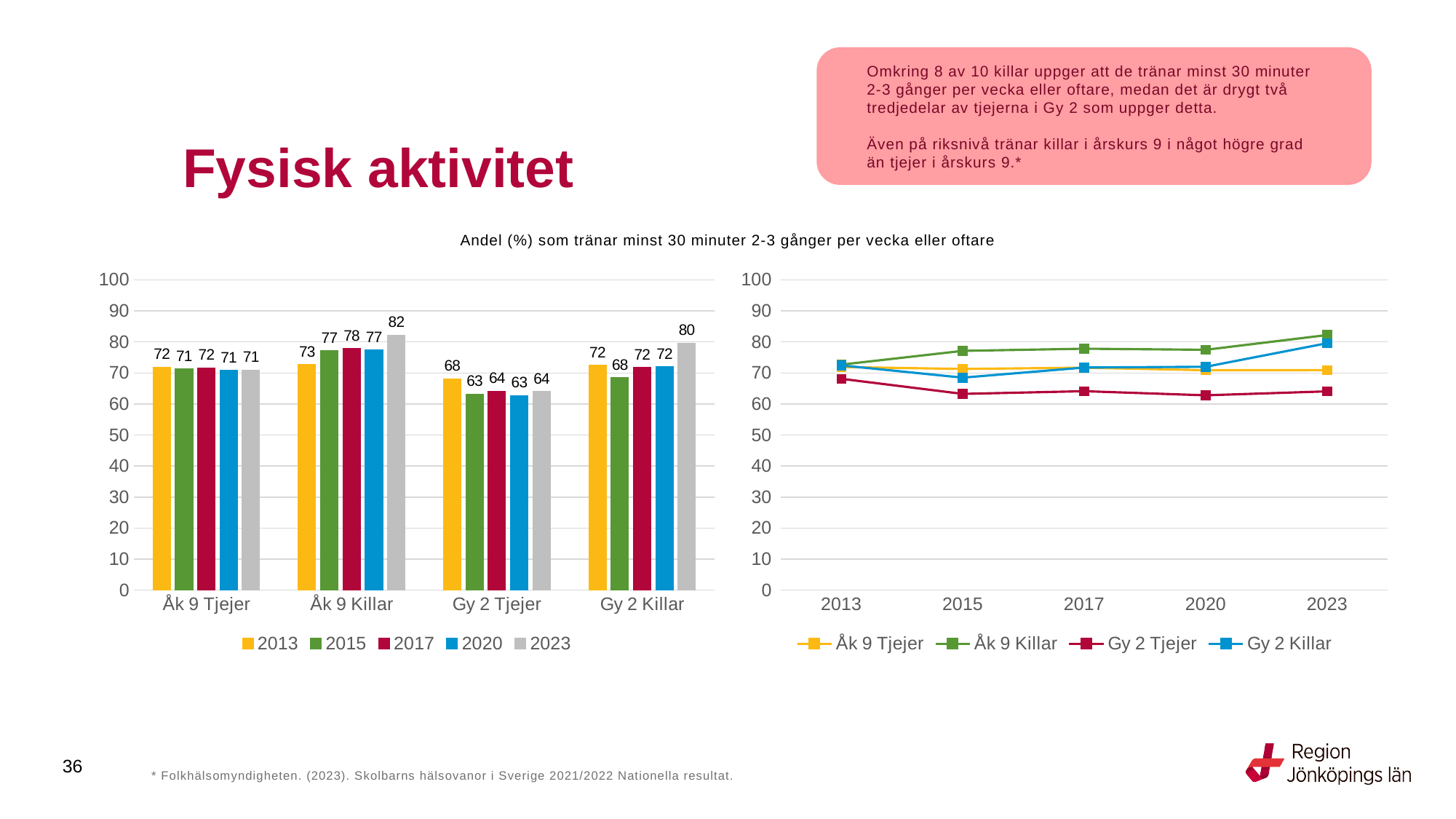
In the bar chart on the left, what is the difference between the 2023 values for Åk 9 Killar and Gy 2 Tjejer? 18 What kind of chart is the chart on the right? Line chart In the bar chart on the left, what is the value for Gy 2 Killar in 2023? 80 In the bar chart on the left, what is the value for Gy 2 Tjejer in 2015? 63 In the bar chart on the left, what is the value for Åk 9 Killar in 2023? 82 How many series does the legend of the bar chart on the left list? 5 In the bar chart on the left, which category has the lowest value in 2017? Gy 2 Tjejer How many categories are shown on the x axis of the bar chart on the left? 4 In the line chart on the right, does the Gy 2 Killar line rise or fall between 2020 and 2023? Rise In the line chart on the right, is the value for Gy 2 Tjejer in 2015 greater or less than 70? less In the bar chart on the left, which is larger: the 2013 value for Åk 9 Killar or the 2013 value for Gy 2 Tjejer? Åk 9 Killar In the bar chart on the left, which category has the highest value in 2023? Åk 9 Killar